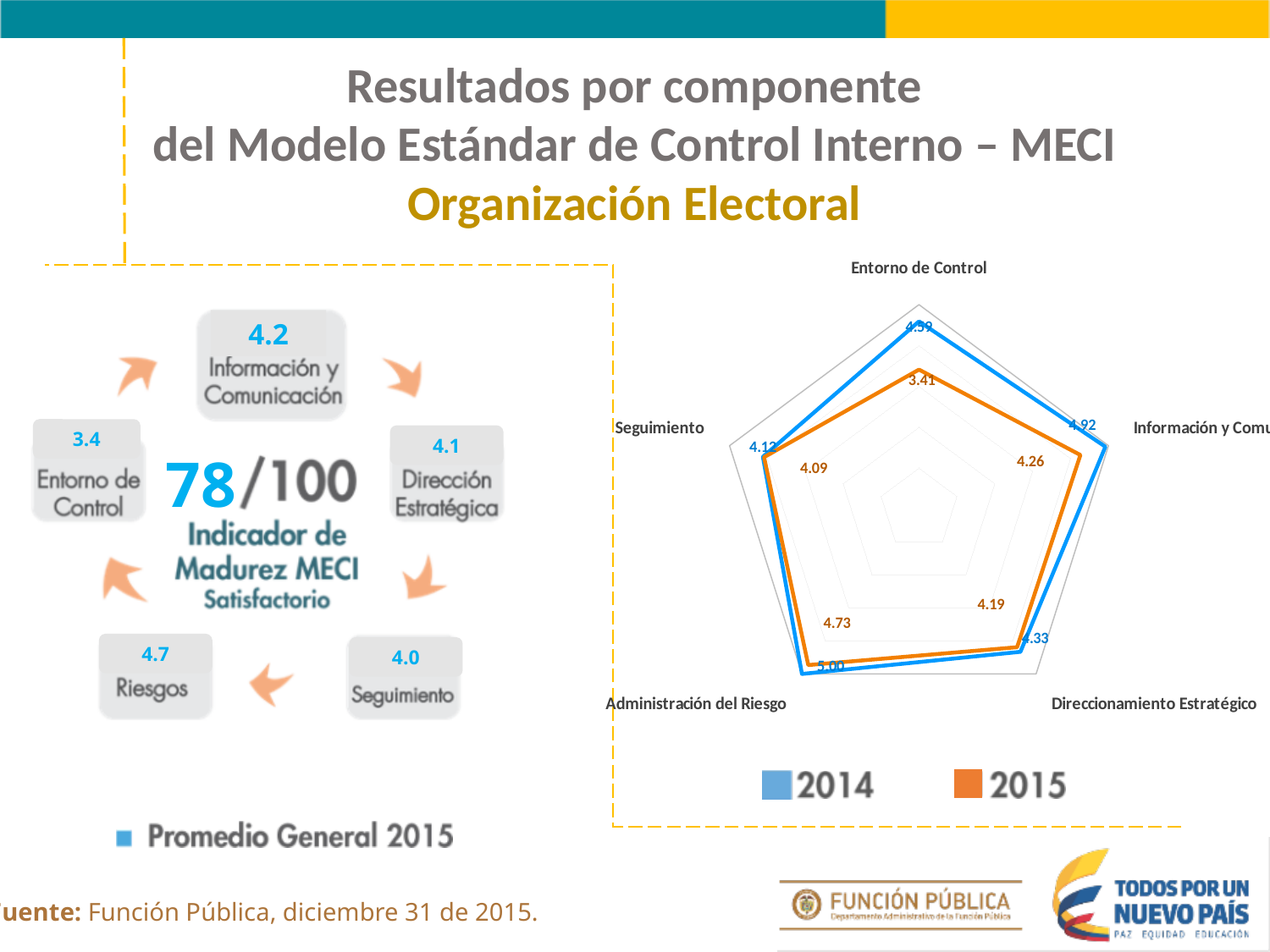
In the radar chart, which component has the lowest 2015 value? Entorno de Control In the radar chart, what is the 2015 value for Seguimiento? 4.09 In the radar chart, which component has the highest 2015 value? Administración del Riesgo In the radar chart, what is the 2014 value for Direccionamiento Estratégico? 4.33 In the radar chart, what is the 2015 value for Entorno de Control? 3.41 In the radar chart, which year has the larger value for Entorno de Control, 2014 or 2015? 2014 What kind of chart is shown on the right side of the slide? Radar chart In the radar chart, what is the difference between the 2014 and 2015 values for Administración del Riesgo? 0.27 In the radar chart, what is the 2015 value for Direccionamiento Estratégico? 4.19 In the radar chart, what is the 2014 value for Administración del Riesgo? 5.00 How many series does the legend of the radar chart list? 2 In the radar chart, what is the 2015 value for Administración del Riesgo? 4.73